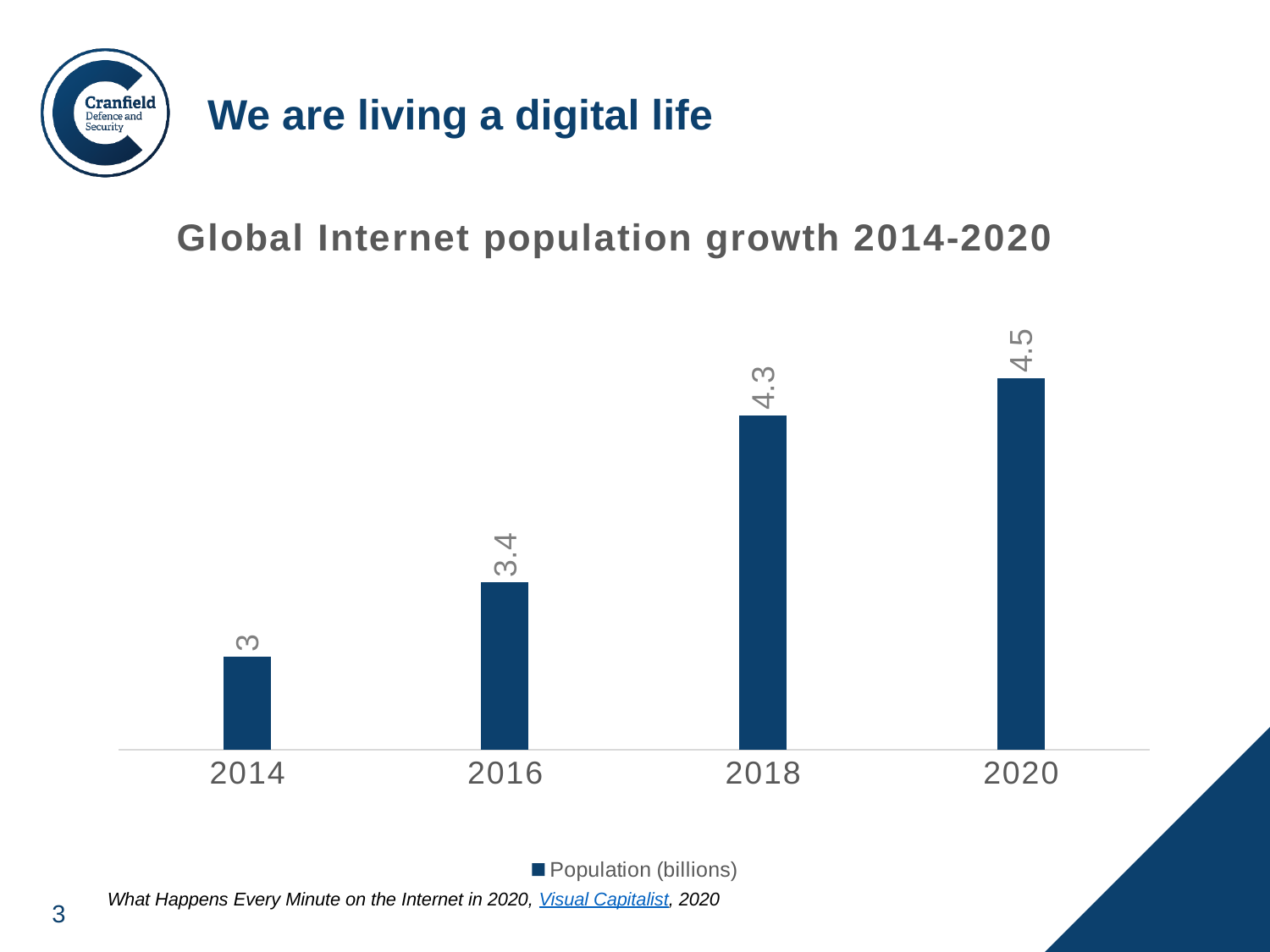
What kind of chart is this? Bar chart What is the value for 2018? 4.3 Which is larger, the value for 2016 or the value for 2018? 2018 What is the value for 2020? 4.5 What is the value for 2014? 3 What is the difference between the values for 2020 and 2014? 1.5 Which year has the lowest value? 2014 How many years are shown on the x axis? 4 Which year has the highest value? 2020 What is the value for 2016? 3.4 Do the values rise or fall from 2014 to 2020? Rise What is the difference between the values for 2018 and 2016? 0.9